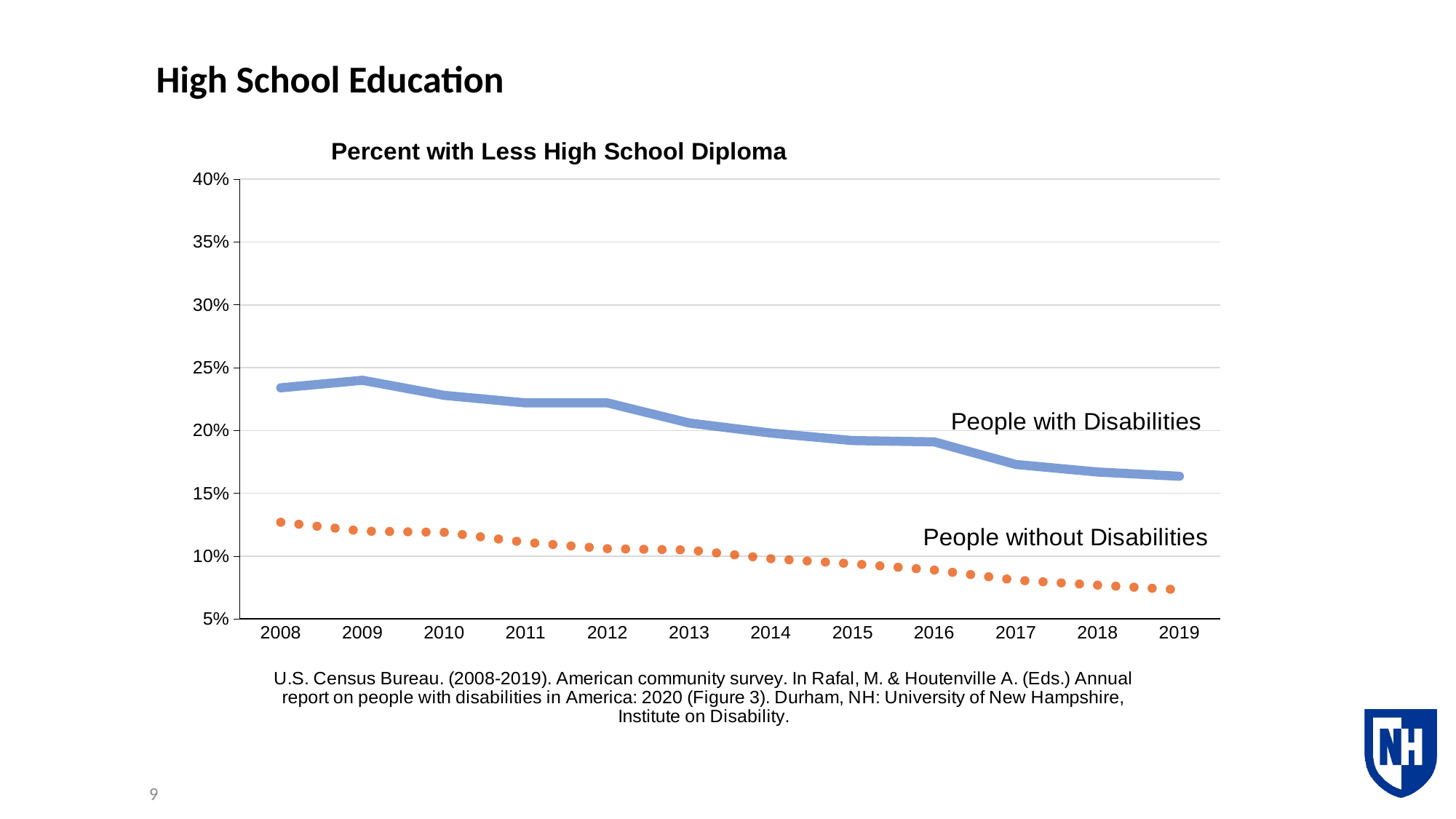
In which year is the value for People without Disabilities lowest? 2019 In 2014, which series has the larger value, People with Disabilities or People without Disabilities? People with Disabilities What is the title of the chart? Percent with Less High School Diploma Is the value for People with Disabilities in 2008 greater or less than 20%? greater What kind of chart is shown on the slide? line chart Do the values for People without Disabilities rise or fall from 2008 to 2019? fall How many years are shown along the x axis of the chart? 12 Do the values for People with Disabilities rise or fall from 2008 to 2019? fall Is the value for People without Disabilities in 2019 greater or less than 10%? less How many series are plotted on the chart? 2 Which series is drawn as a dotted line? People without Disabilities Is the value for People with Disabilities in 2019 greater or less than 20%? less